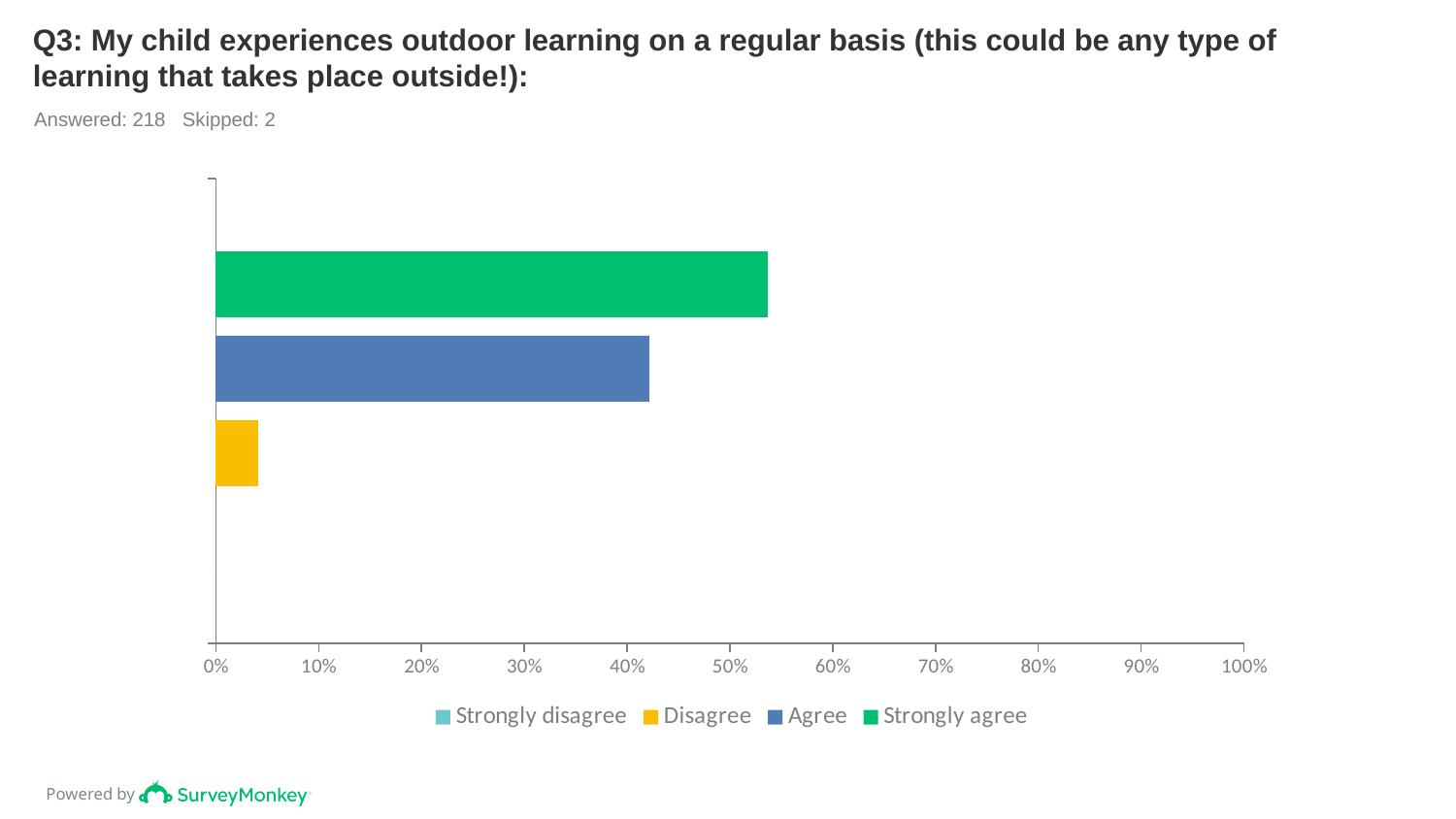
What colour is the bar for Strongly agree? Green Is the value for Agree greater or less than 50%? less How many response options does the legend list? 4 How many respondents answered this question according to the slide? 218 What kind of chart is shown on the slide? Bar chart Which is larger, the value for Disagree or the value for Agree? Agree Is the value for Strongly agree greater or less than 50%? greater Is the value for Agree greater or less than 40%? greater Which is larger, the value for Strongly agree or the value for Agree? Strongly agree Which response option has the longest bar? Strongly agree